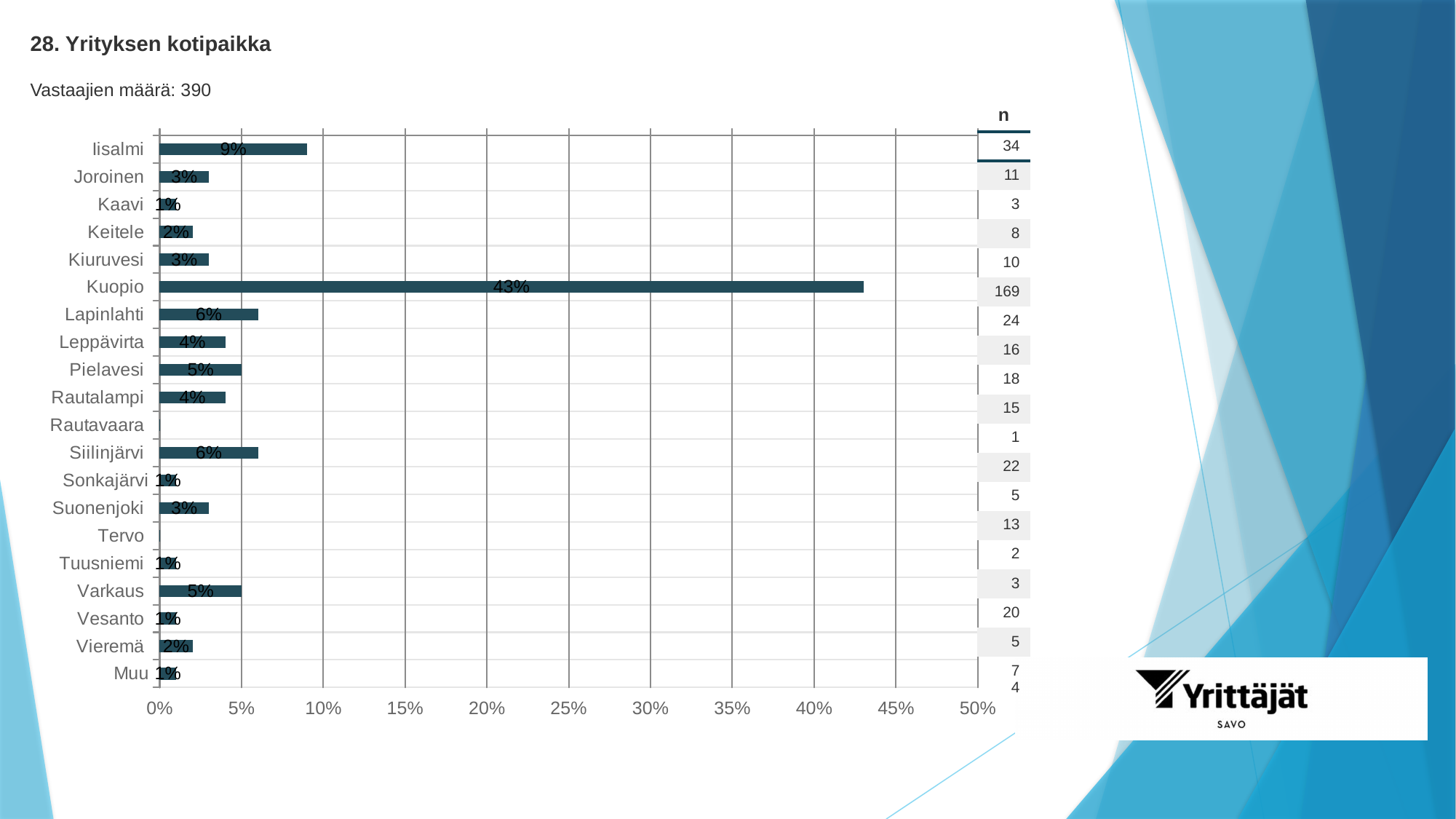
What is the value for Kuopio? 43% Is the value for Kuopio greater or less than 40%? greater What is the value for Iisalmi? 9% Which category has the highest value? Kuopio What is the value for Lapinlahti? 6% What is the title of the slide? 28. Yrityksen kotipaikka What is the difference between the values for Kuopio and Iisalmi? 34% Which is larger, the value for Pielavesi or the value for Leppävirta? Pielavesi What kind of chart is shown on the slide? bar chart What is the value for Varkaus? 5% What is the number of respondents (Vastaajien määrä) stated on the slide? 390 How many categories are shown on the y axis of the chart? 20